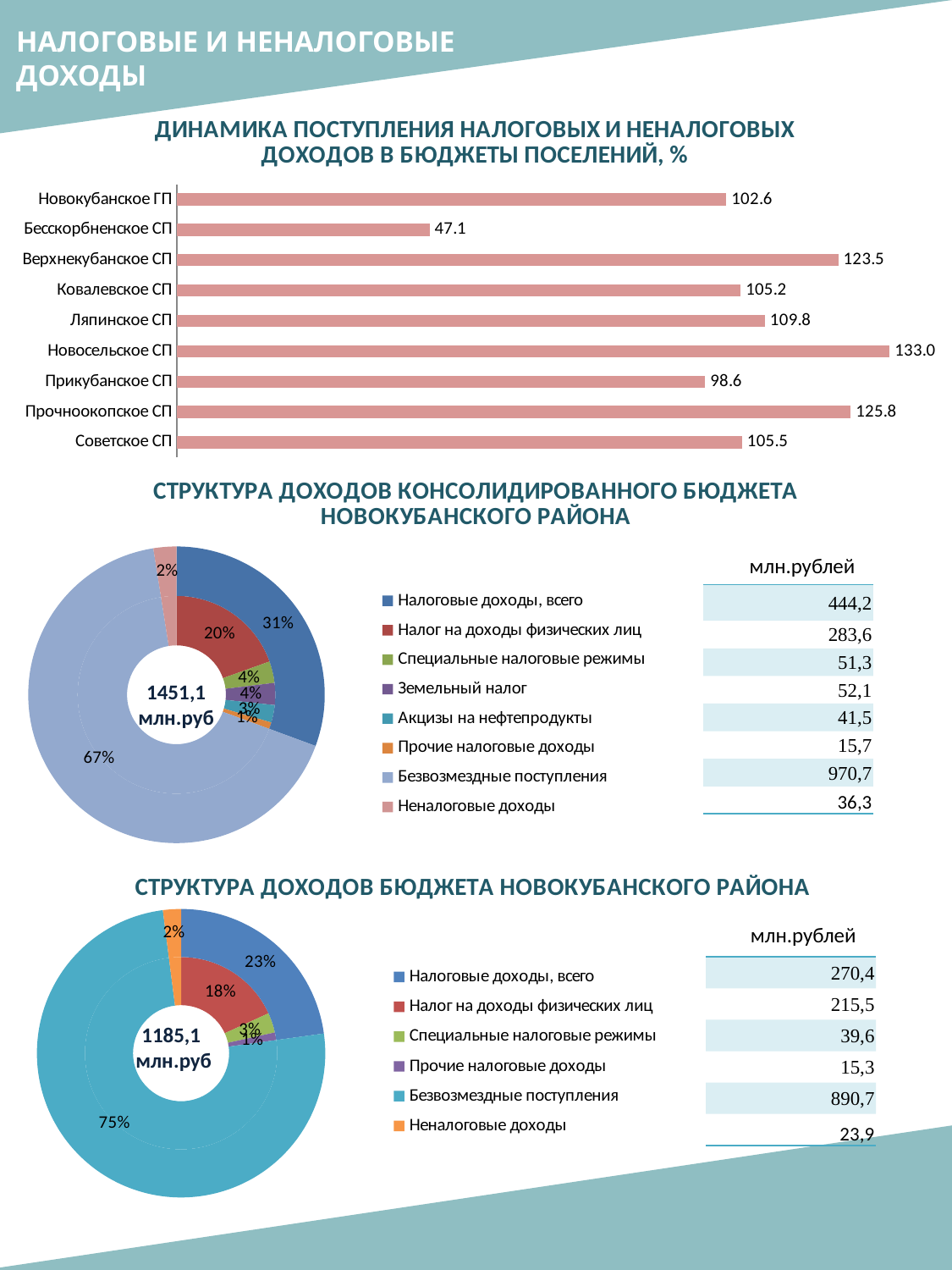
What kind of chart is 'Динамика поступления налоговых и неналоговых доходов в бюджеты поселений, %'? Bar chart In the bar chart 'Динамика поступления налоговых и неналоговых доходов в бюджеты поселений, %', which category has the highest value? Новосельское СП What total is shown in the centre of the doughnut chart 'Структура доходов бюджета Новокубанского района'? 1185,1 млн.руб In the chart 'Структура доходов консолидированного бюджета Новокубанского района', what share do Безвозмездные поступления have? 67% In the bar chart 'Динамика поступления налоговых и неналоговых доходов в бюджеты поселений, %', which category has the lowest value? Бесскорбненское СП In the bar chart 'Динамика поступления налоговых и неналоговых доходов в бюджеты поселений, %', what is the difference between Верхнекубанское СП and Прикубанское СП? 24.9 In the bar chart 'Динамика поступления налоговых и неналоговых доходов в бюджеты поселений, %', what is the value for Ляпинское СП? 109.8 In the bar chart 'Динамика поступления налоговых и неналоговых доходов в бюджеты поселений, %', which is larger: Прочноокопское СП or Ковалевское СП? Прочноокопское СП How many entries does the legend of the chart 'Структура доходов бюджета Новокубанского района' list? 6 How many categories are shown in the bar chart 'Динамика поступления налоговых и неналоговых доходов в бюджеты поселений, %'? 9 In the chart 'Структура доходов консолидированного бюджета Новокубанского района', what is the value in млн.рублей for Налог на доходы физических лиц? 283,6 In the chart 'Структура доходов бюджета Новокубанского района', what share do Налоговые доходы, всего have? 23%